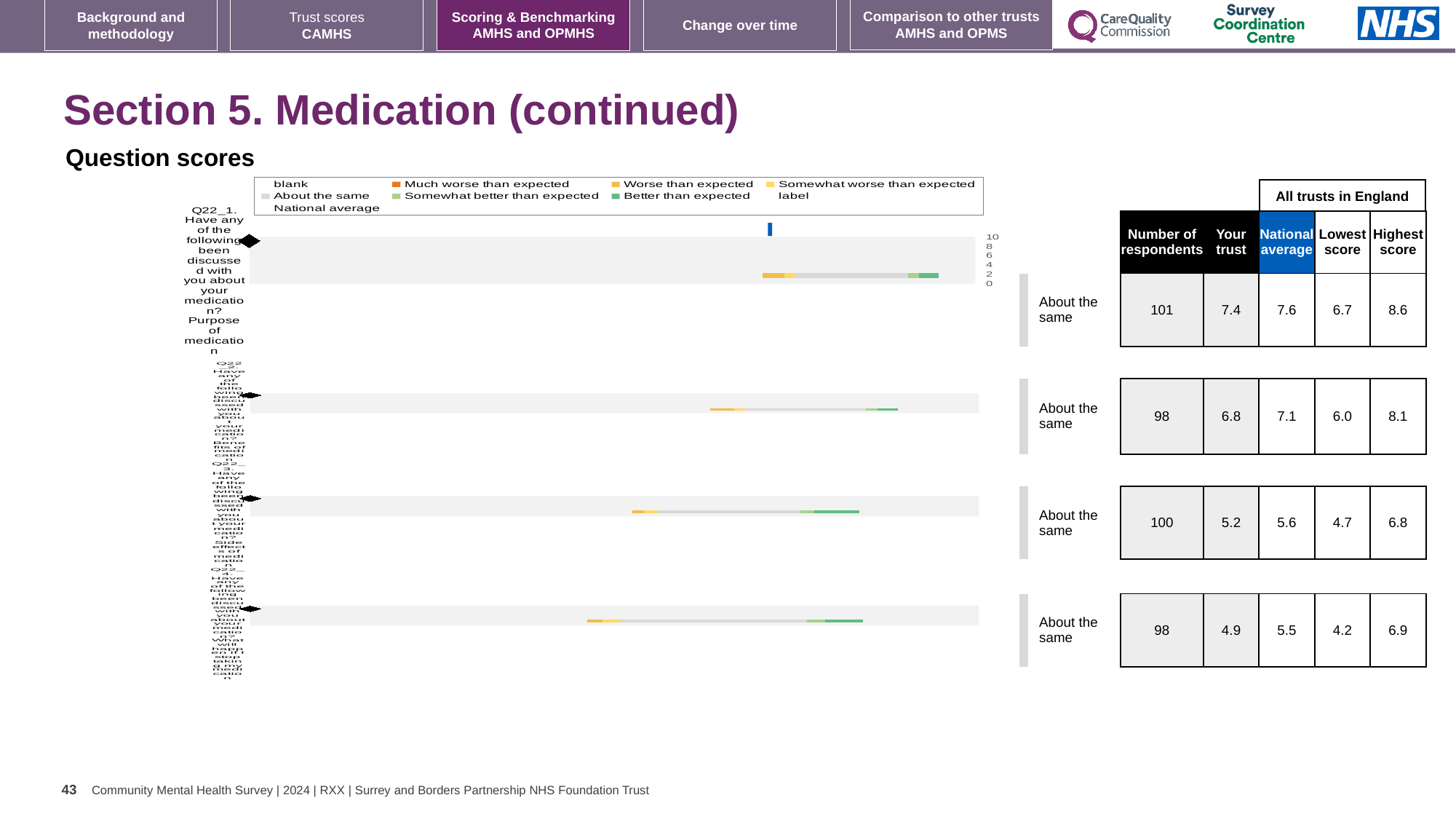
In the table beside the chart, what is the 'Your trust' score for Q22_1 (Purpose of medication)? 7.4 What is the lowest 'Your trust' score listed in the table beside the chart? 4.9 Which legend entry is shown in dark green in the chart legend? Better than expected In the table beside the chart, how many respondents are listed for the first question row? 101 What is the highest value shown on the chart's score axis? 10 For Q22_1, what is the difference between the national average (7.6) and the 'Your trust' score (7.4)? 0.2 How many question bars are plotted in the chart? 4 Which question row has the highest 'Your trust' score in the table beside the chart? Q22_1 (Purpose of medication) In the table beside the chart, what is the national average for Q22_1 (Purpose of medication)? 7.6 For Q22_1, which is larger: the 'Your trust' score or the national average? National average What kind of chart is shown under 'Question scores'? bar chart In the table beside the chart, what is the highest score for the fourth question row? 6.9